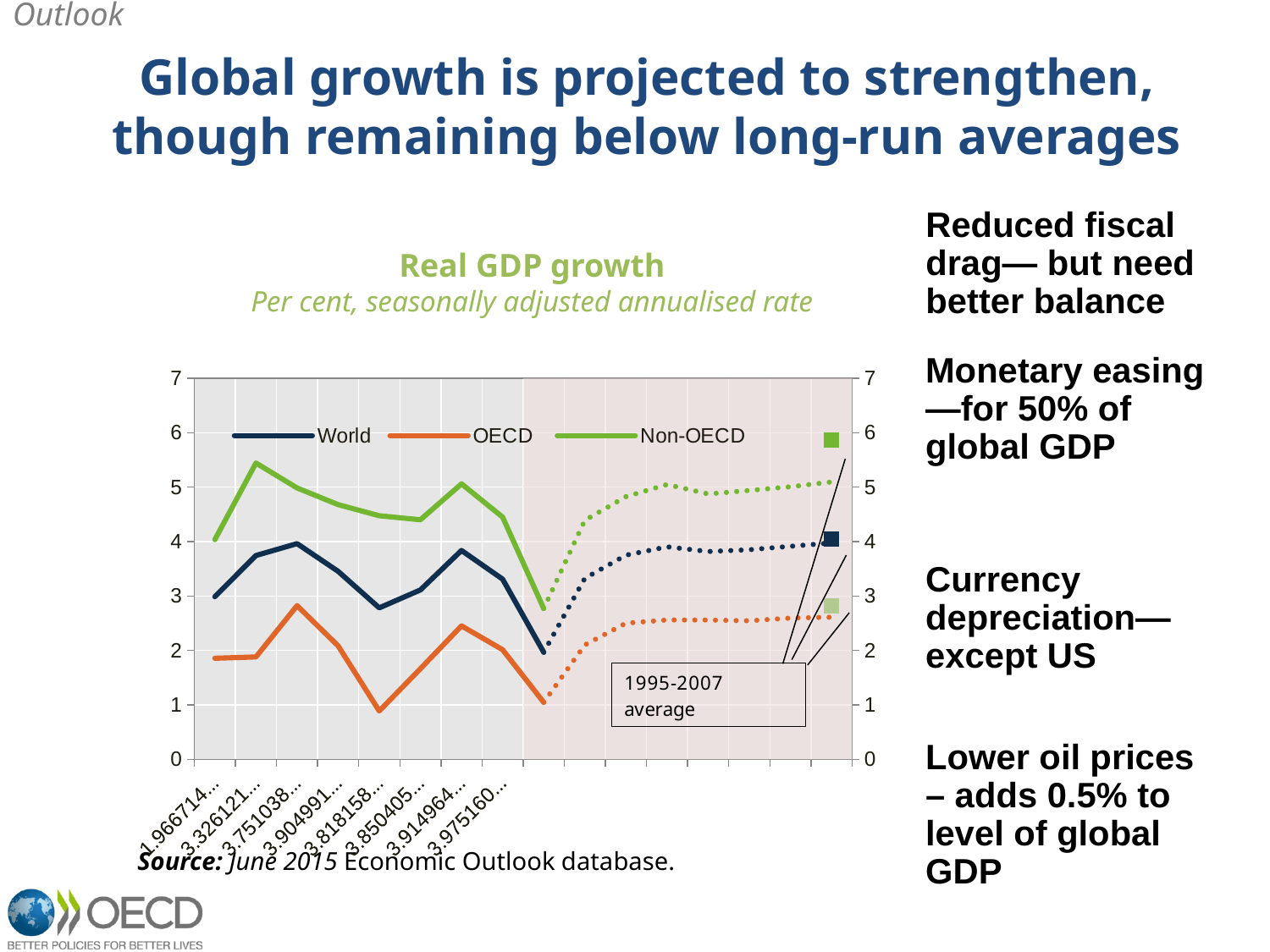
Is the peak value of the OECD line greater or less than 3? less Is the peak value of the Non-OECD line greater or less than 5? greater What are the three series named in the chart legend? World, OECD, Non-OECD Is the lowest value of the Non-OECD solid line greater or less than 3? less What type of chart is shown on the slide? line chart Which series is larger at every point on the chart, OECD or Non-OECD? Non-OECD What is the maximum value shown on the chart's vertical axis? 7 How many series does the chart legend list? 3 Which series has the lowest values throughout the chart? OECD Which series has the highest values throughout the chart? Non-OECD What is the title of the chart? Real GDP growth